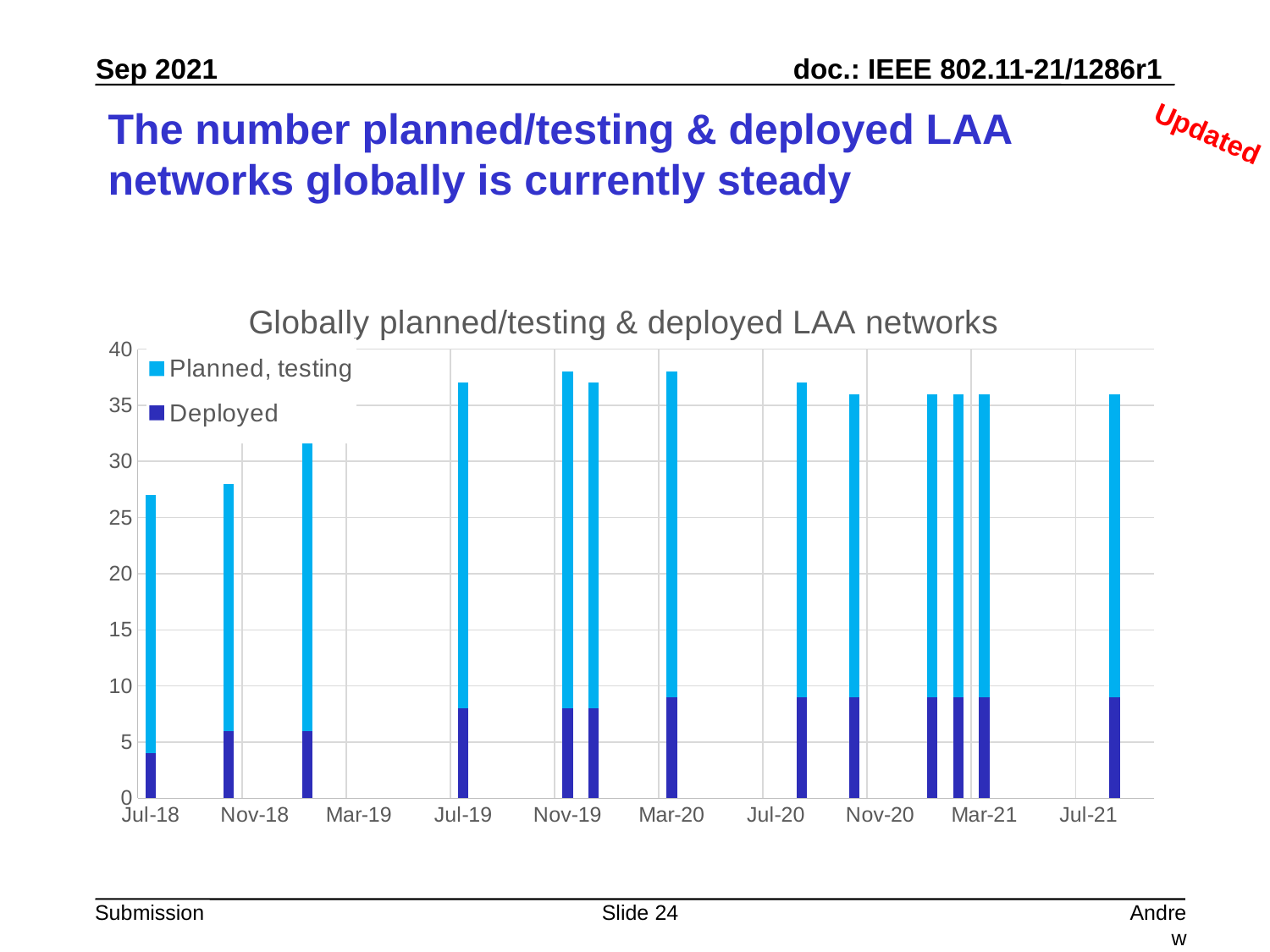
Is the Deployed value at Mar-20 greater or less than 10? less Is the total height of the bar at Jul-18 greater or less than 30? less Which bar is taller in total, Jul-18 or Jul-19? Jul-19 What kind of chart is shown on the slide? Stacked bar chart Is the Deployed value at Jul-18 greater or less than 5? less What is the title of the chart? Globally planned/testing & deployed LAA networks What are the two series named in the chart legend? Planned, testing; Deployed Do the total bar heights rise or fall from Jul-18 to Jul-19? rise How many series does the chart legend list? 2 Which has the larger Deployed value, Jul-18 or Mar-20? Mar-20